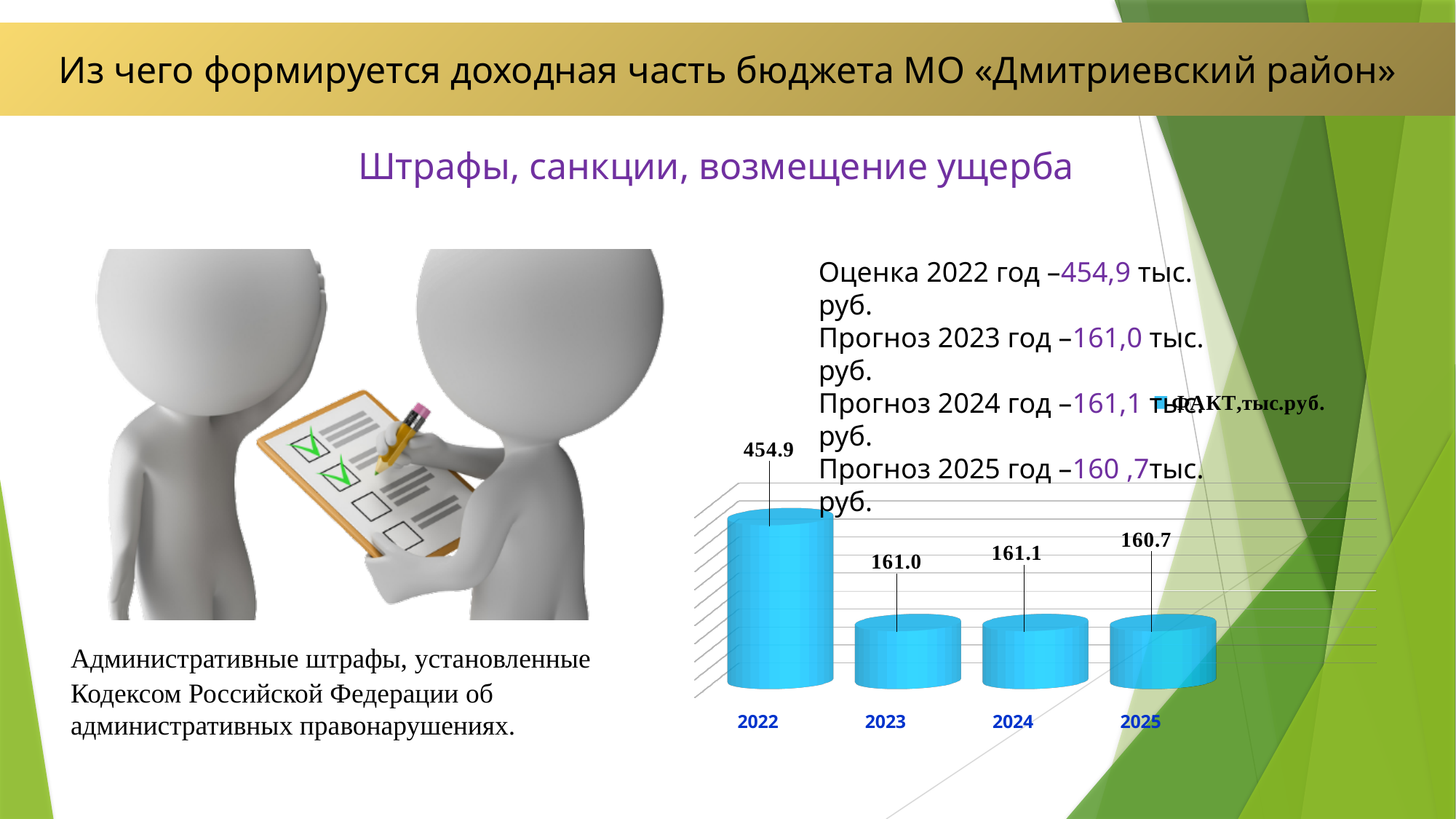
Which year has the highest value in the chart? 2022 Which is larger, the value for 2022 or the value for 2024? 2022 How many years are shown on the x axis of the chart? 4 What is the value for 2024 in the chart? 161.1 What is the value for 2023 in the chart? 161.0 What is the difference between the values for 2022 and 2023? 293.9 Which year has the lowest value in the chart? 2025 What kind of chart is shown on the slide? bar chart Overall, do the values rise or fall from 2022 to 2025? fall What is the value for 2025 in the chart? 160.7 What is the value for 2022 in the chart? 454.9 What is the difference between the values for 2024 and 2025? 0.4